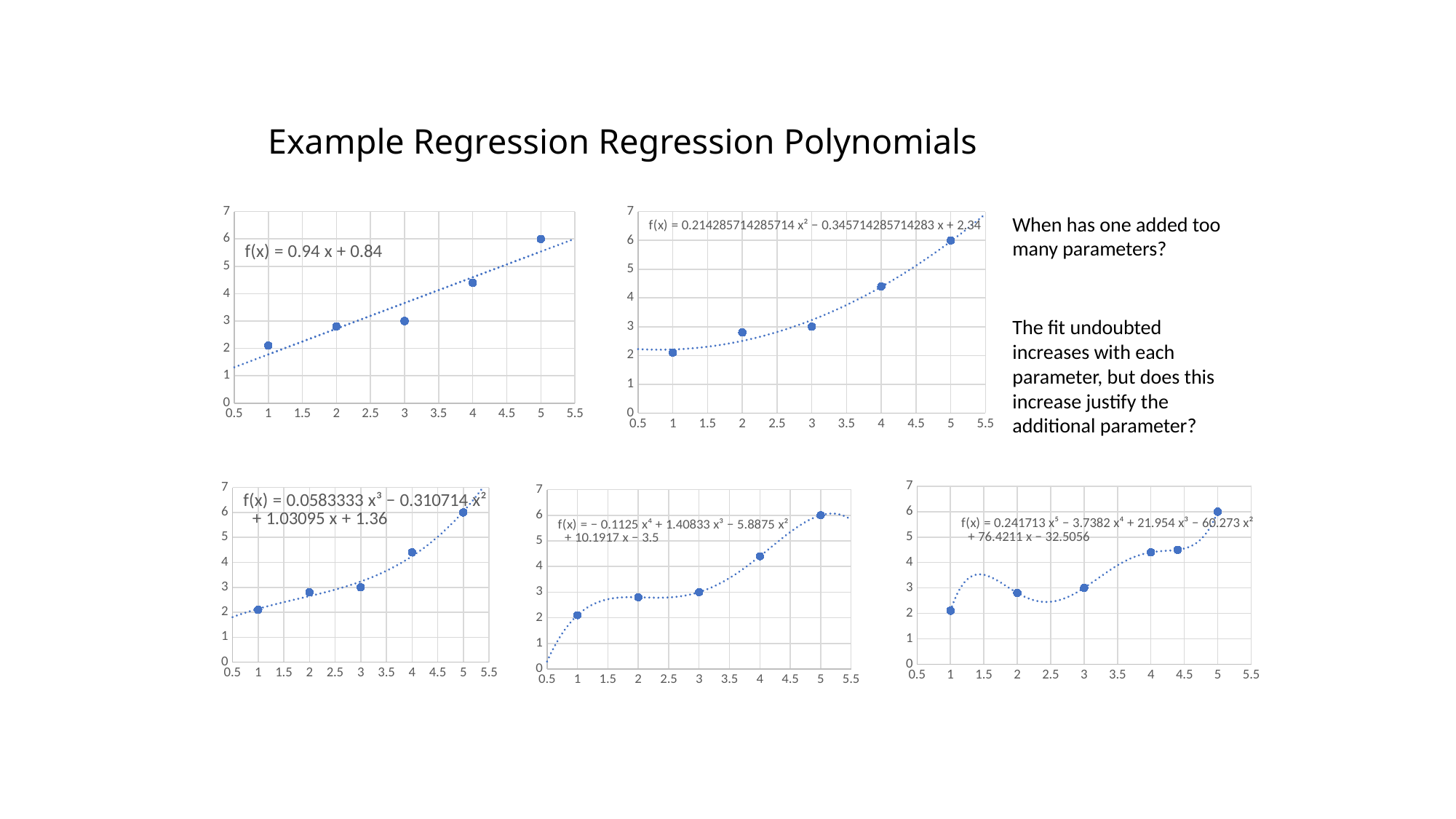
In the top-right chart, at which x value is the highest plotted point? 5 In the top-left chart, do the plotted values rise or fall as x increases? rise In the top-left chart, is the value of the point at x = 5 greater or less than 5? greater What kind of chart is the top-left chart on the slide? scatter chart In the top-right chart, is the value of the point at x = 4 greater or less than 4? greater How many data points are plotted in the bottom-right chart? 6 In the bottom-right chart, which point has the larger value: the one at x = 2 or the one at x = 4? x = 4 In the bottom-left chart, at which x value is the lowest plotted point? 1 What is the highest value shown on the y axis of the bottom-left chart? 7 How many data points are plotted in the top-left chart? 5 What is the fitted equation shown in the top-left chart? f(x) = 0.94 x + 0.84 In the bottom-middle chart, is the value of the point at x = 1 greater or less than 3? less